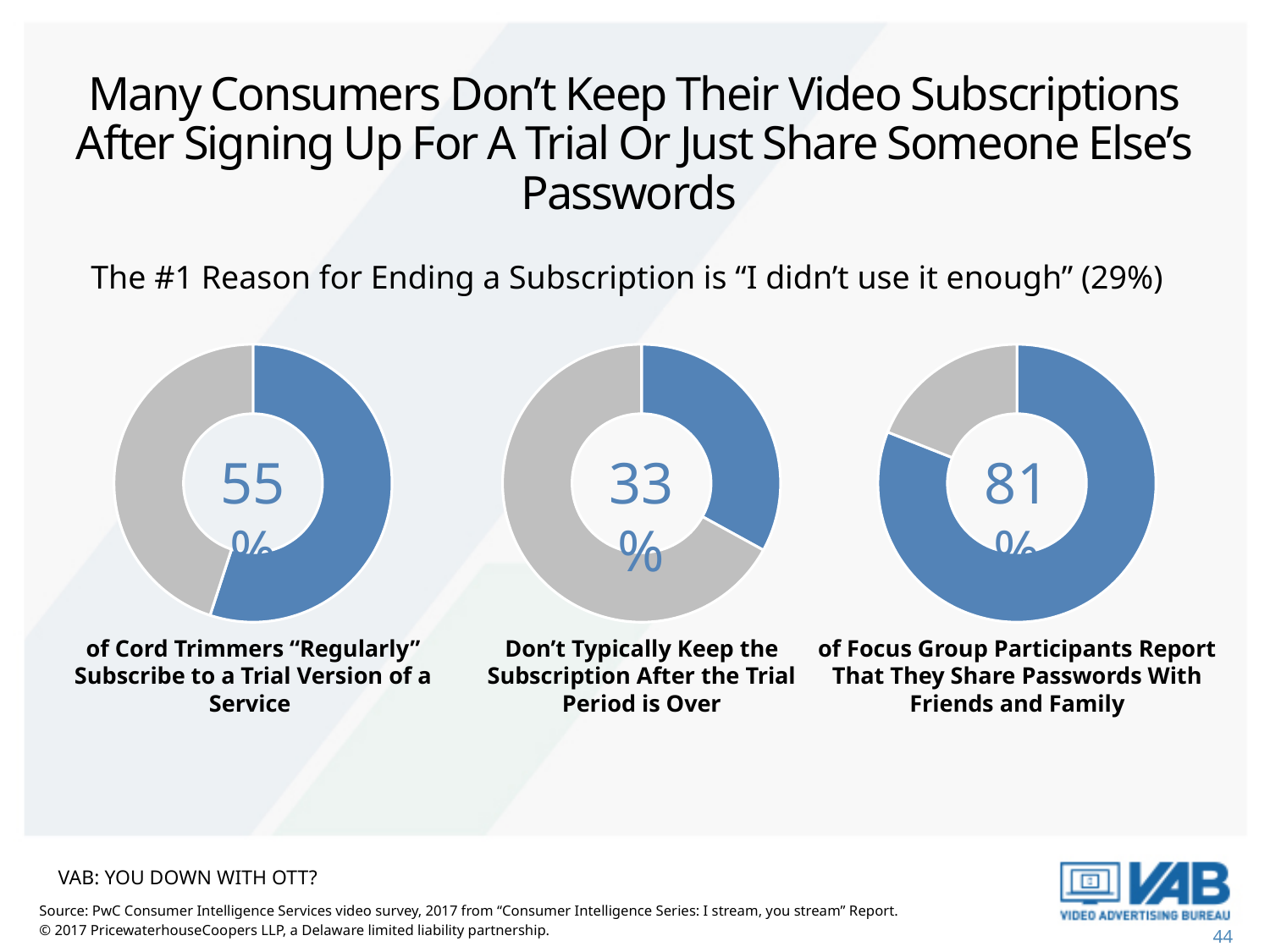
In the right donut chart, what percentage of focus group participants report that they share passwords with friends and family? 81% How many donut charts are shown on the slide? 3 What type of chart is used to display the three percentages on the slide? Donut (pie) chart What does the right donut chart's 81% represent? Focus group participants who report sharing passwords with friends and family In the middle donut chart, what percentage don't typically keep the subscription after the trial period is over? 33% What colour is used for the highlighted (value) slice in each donut chart? Blue Which is larger: the percentage in the left chart (trial subscribers) or the percentage in the middle chart (don't keep subscription after trial)? The left chart (55%) What is the difference between the percentage in the left chart (55%) and the percentage in the middle chart (33%)? 22 percentage points What is the difference between the percentage in the right chart (81%) and the percentage in the left chart (55%)? 26 percentage points In the left donut chart, what percentage of Cord Trimmers "Regularly" subscribe to a trial version of a service? 55% Which of the three donut charts shows the highest percentage? The right chart (share passwords with friends and family), 81% Which of the three donut charts shows the lowest percentage? The middle chart (don't keep the subscription after the trial), 33%